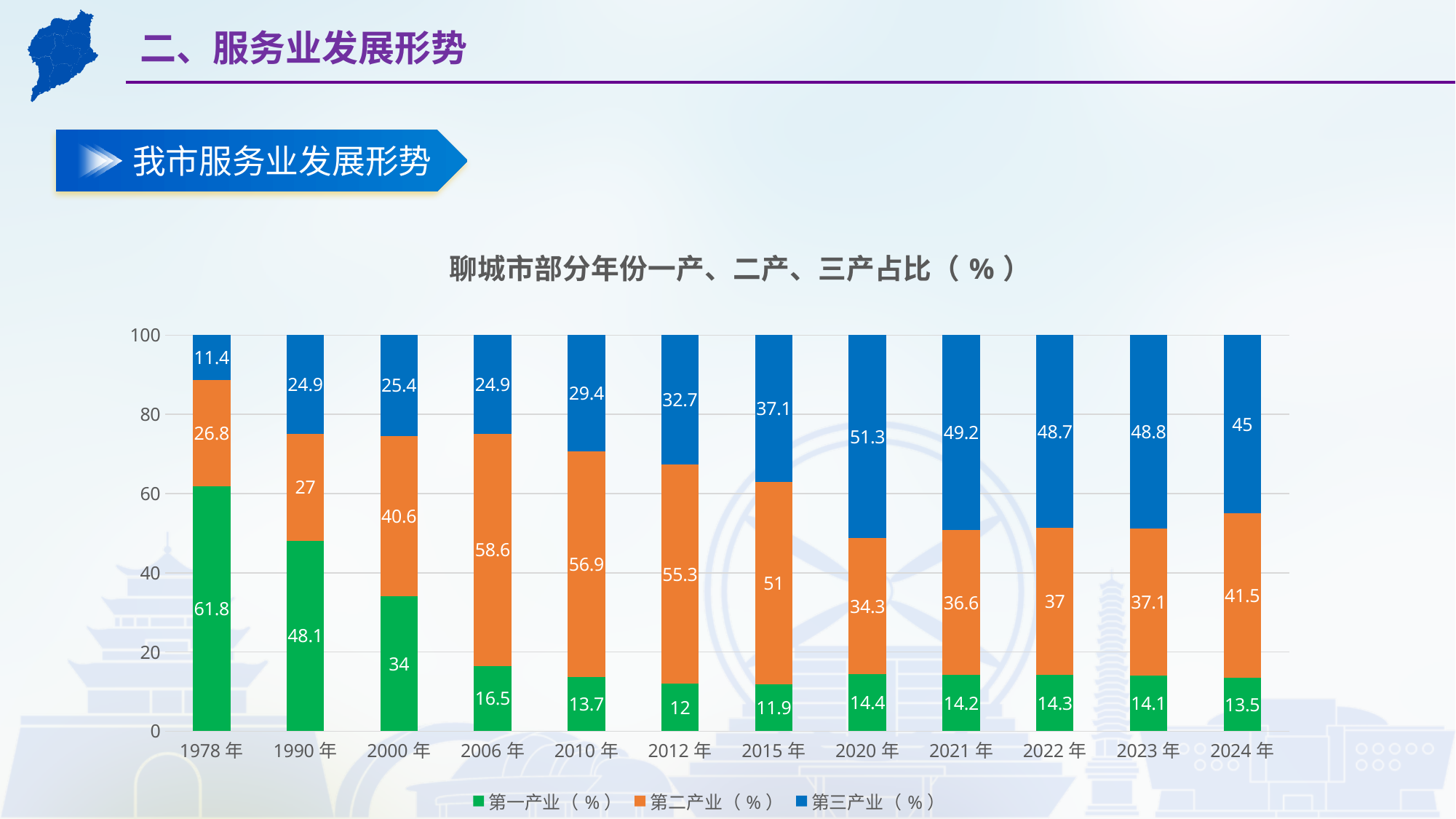
How many series does the legend list? 3 What is the value of 第二产业 for 2006 年? 58.6 Which year has the lowest value for 第一产业? 2015 年 Which is larger, the 第二产业 value for 2024 年 or for 2023 年? 2024 年 What is the title of the chart? 聊城市部分年份一产、二产、三产占比（%） What is the difference between the 第三产业 values for 2020 年 and 1978 年? 39.9 Does the value of 第一产业 rise or fall from 1978 年 to 2006 年? Fall How many years are shown on the x axis? 12 Which year has the highest value for 第三产业? 2020 年 What is the value of 第三产业 for 2024 年? 45 What kind of chart is shown on the slide? Stacked bar chart What is the value of 第一产业 for 1978 年? 61.8